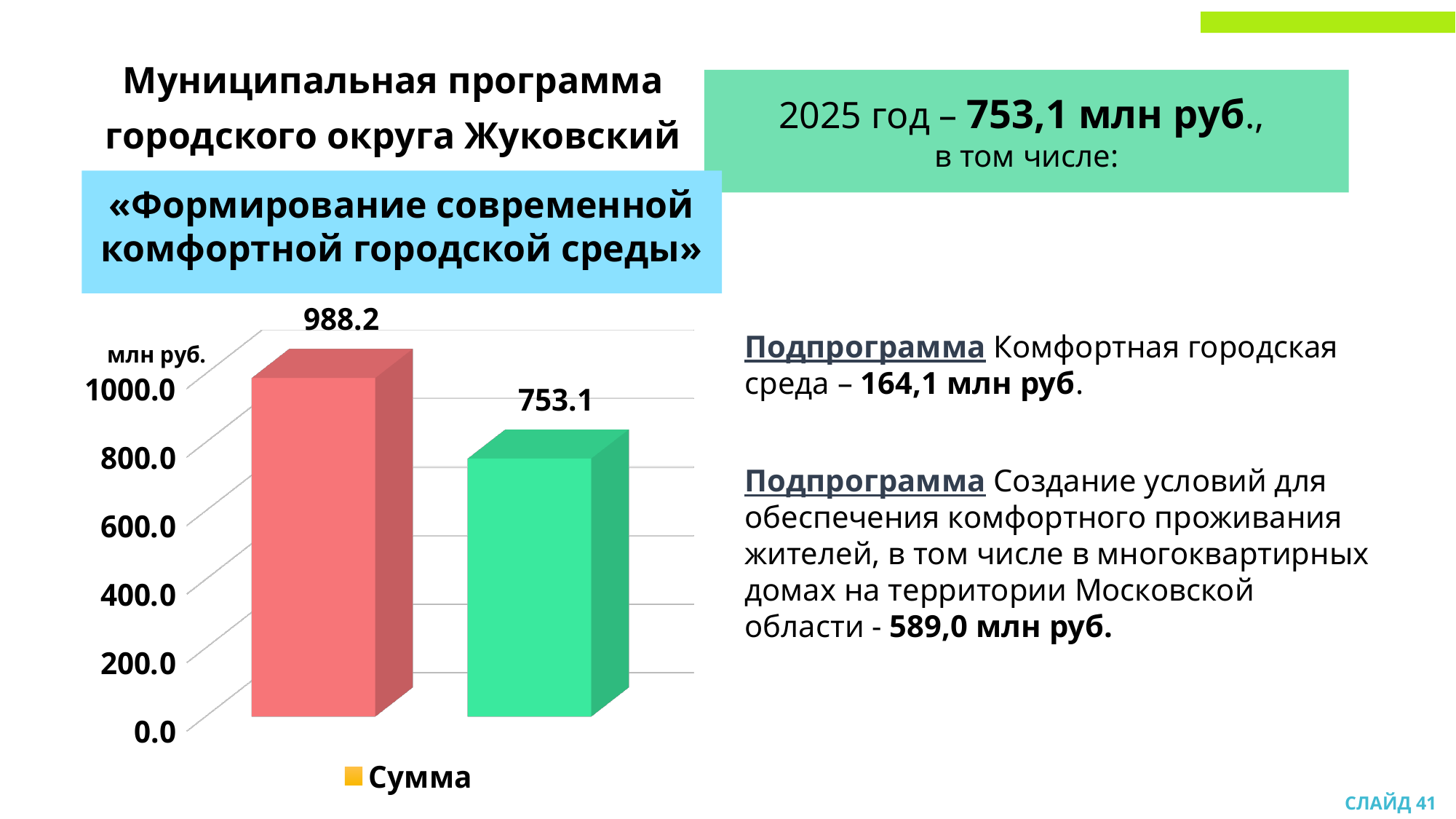
Which bar has the highest value, the left red bar or the right green bar? the left red bar What is the value of the right (green) bar in the chart? 753.1 How many series does the chart legend list? 1 What kind of chart is shown on the slide? bar chart Is the value of the red bar larger or smaller than the value of the green bar? larger How many bars are plotted in the chart? 2 What is the difference between the left bar (988.2) and the right bar (753.1)? 235.1 Do the values rise or fall from the left bar to the right bar? fall What is the value of the left (red) bar in the chart? 988.2 Which bar has the lowest value, the left red bar or the right green bar? the right green bar What is the name of the series shown in the chart legend? Сумма Is the value of the green bar greater or less than 800.0? less